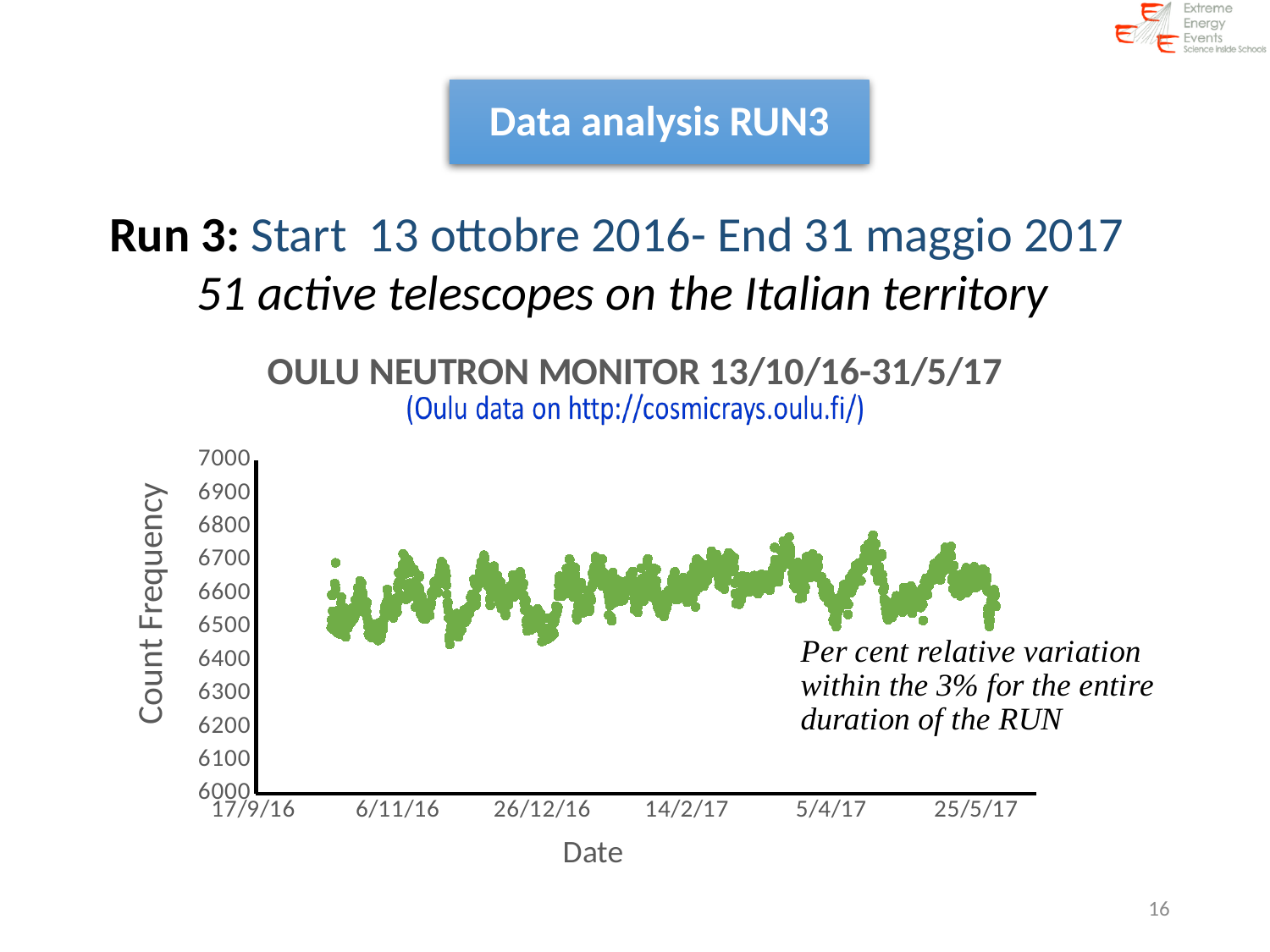
Are the plotted count frequency values around 26/12/16 greater or less than 6300? greater What is the last date tick label on the horizontal axis? 25/5/17 What is the first date tick label on the horizontal axis? 17/9/16 Are the plotted count frequency values around 5/4/17 greater or less than 6800? less What is the highest tick value shown on the vertical axis? 7000 What kind of chart is shown on the slide? scatter chart What is the label of the vertical axis of the chart? Count Frequency What is the title of the chart? OULU NEUTRON MONITOR 13/10/16-31/5/17 Are all the plotted count frequency values greater or less than 6900? less What is the lowest tick value shown on the vertical axis? 6000 How many date tick labels are shown on the horizontal axis? 6